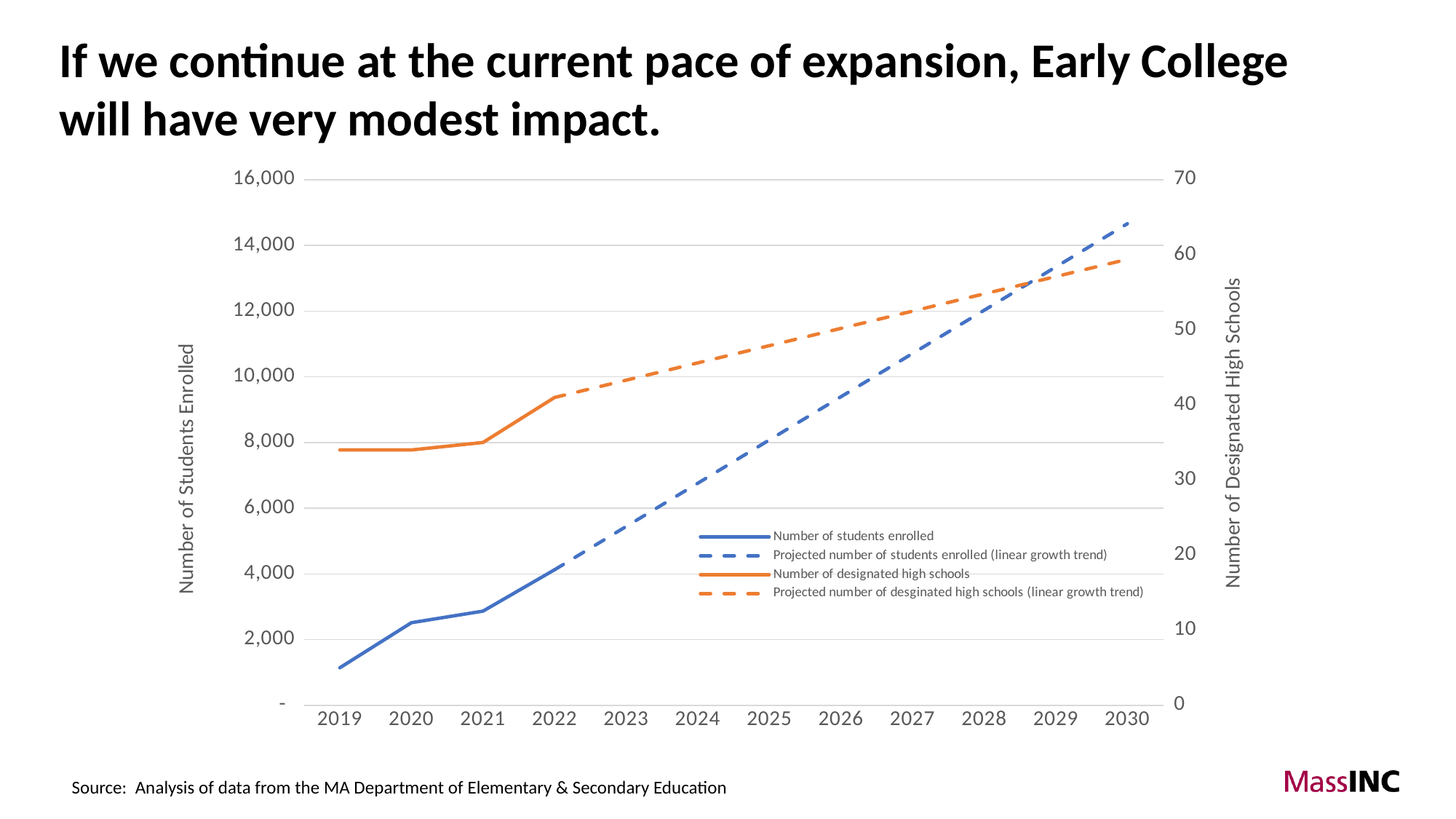
Is the number of students enrolled in 2019 greater or less than 2,000? less Is the projected number of designated high schools in 2030 greater or less than 50? greater How many series does the legend list? 4 Which is larger, the number of students enrolled in 2020 or in 2021? 2021 Which year has the lowest number of students enrolled? 2019 What is the title of the right-hand vertical axis? Number of Designated High Schools Is the number of designated high schools in 2019 greater or less than 30? greater How many years are shown along the x axis? 12 What kind of chart is shown on the slide? line chart Does the number of students enrolled rise or fall from 2019 to 2022? rise